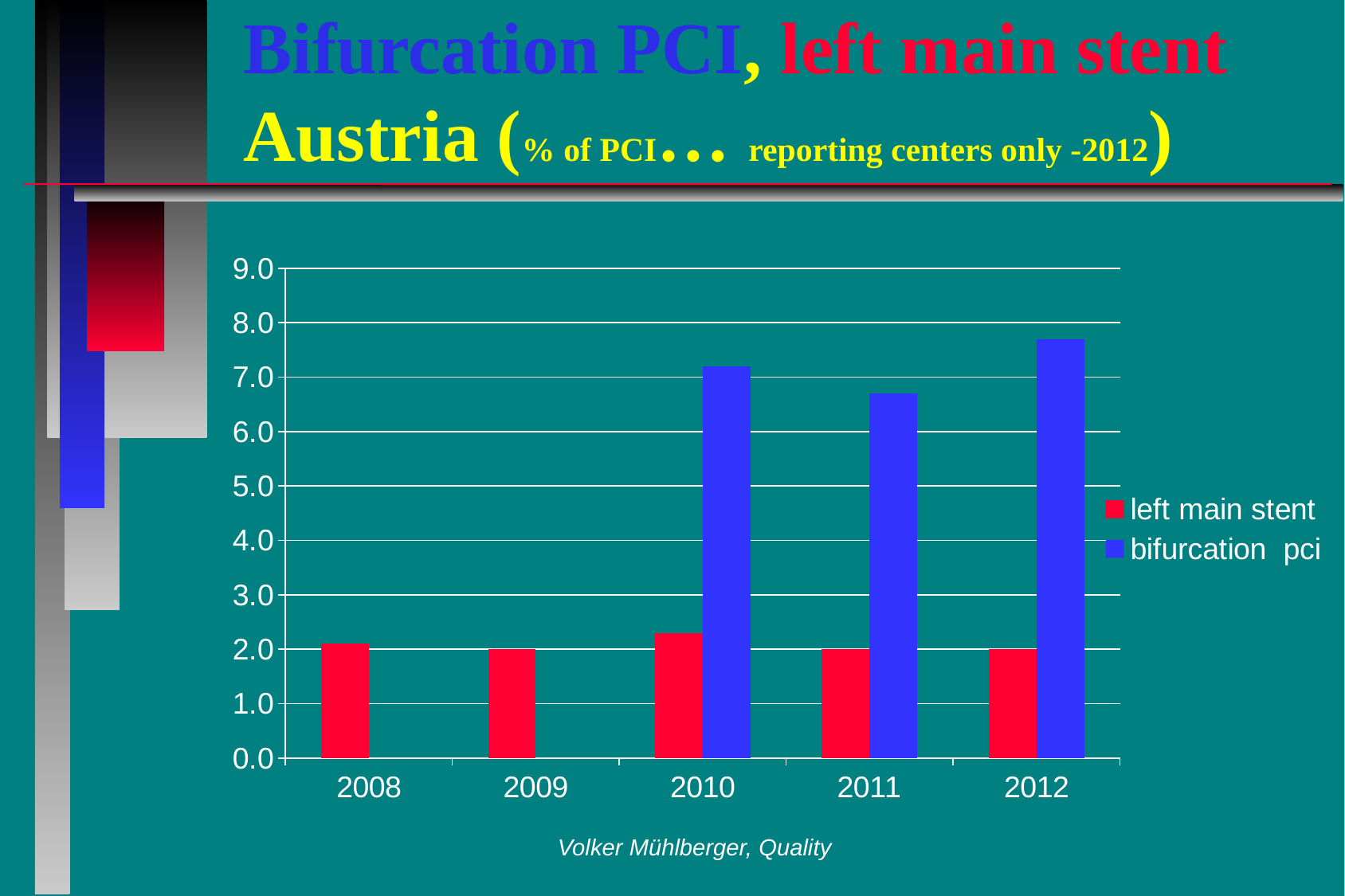
Which is larger: bifurcation pci in 2010 or bifurcation pci in 2011? bifurcation pci in 2010 Is the value for bifurcation pci in 2012 greater or less than 7.0? greater In which year does a bifurcation pci bar first appear? 2010 Is the value for left main stent in 2010 greater or less than 2.0? greater Is the value for bifurcation pci in 2010 greater or less than 7.0? greater Which year has the highest value for bifurcation pci? 2012 How many years are shown on the x axis? 5 How many series does the legend list? 2 Among the years with a bifurcation pci bar, which year has the lowest value? 2011 Which series is shown in blue in the legend? bifurcation pci What kind of chart is shown on the slide? bar chart